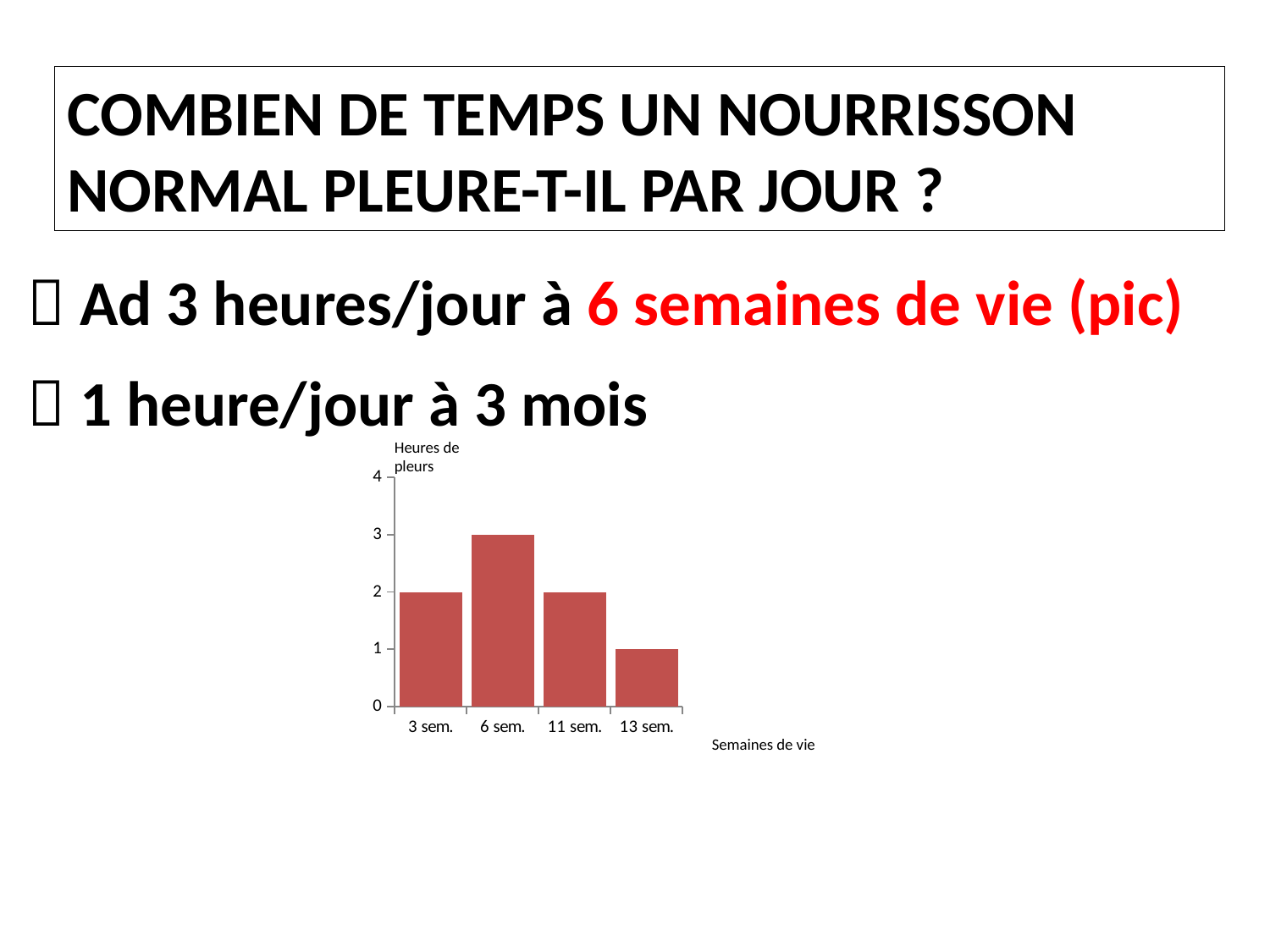
Which category has the highest value in the chart? 6 sem. Is the value for 11 sem. greater or less than 3? less What is the label of the vertical axis of the chart? Heures de pleurs Do the values rise or fall from 6 sem. to 13 sem. along the x axis? fall How many categories are shown on the x axis of the chart? 4 What is the value for 6 sem. in the chart? 3 What is the value for 3 sem. in the chart? 2 What is the value for 13 sem. in the chart? 1 Which category has the lowest value in the chart? 13 sem. What kind of chart is shown on the slide? bar chart What is the difference between the values for 6 sem. and 13 sem.? 2 Which is larger, the value for 6 sem. or the value for 11 sem.? 6 sem.